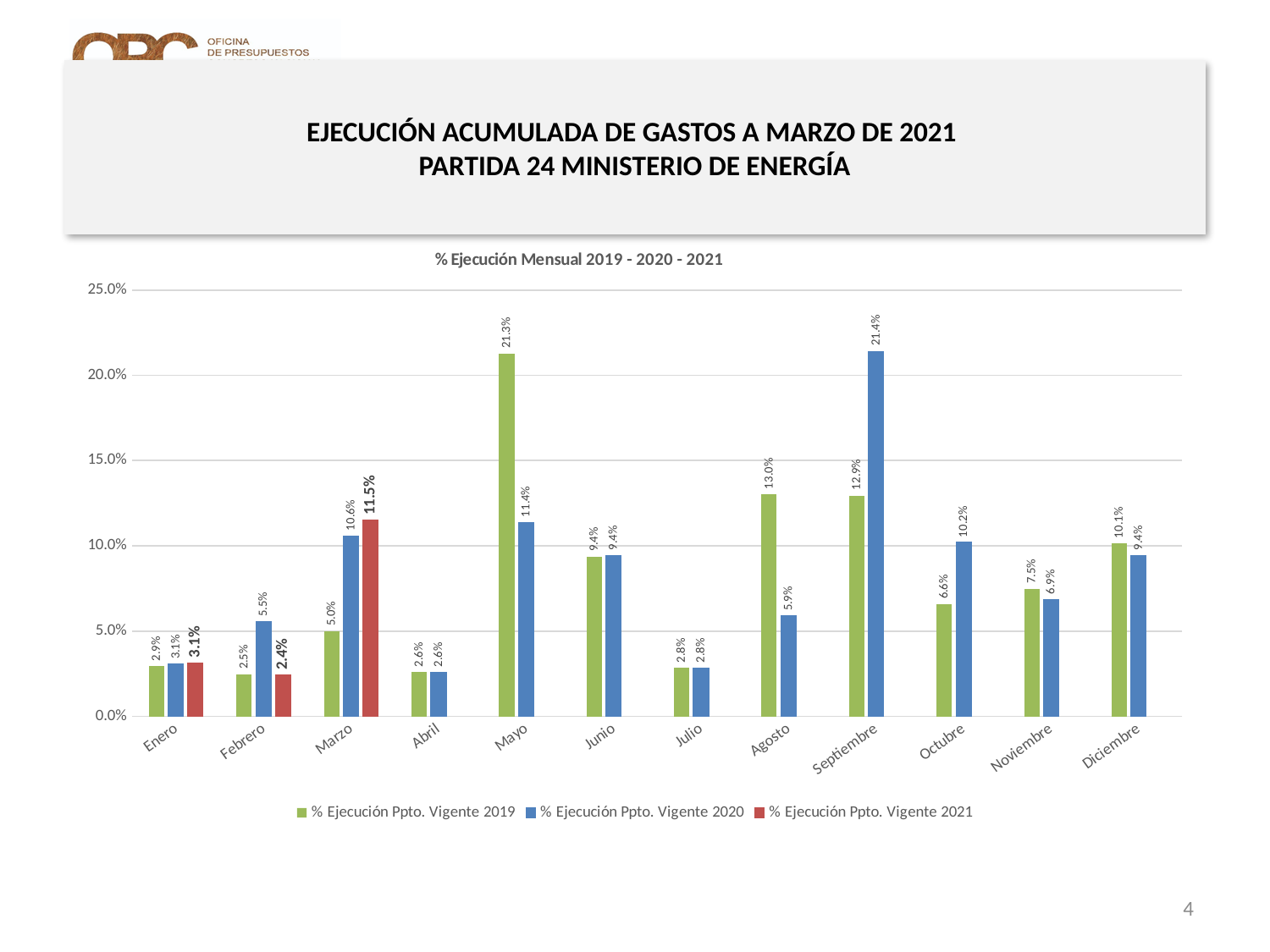
What is the value for % Ejecución Ppto. Vigente 2020 in Octubre? 10.2% What kind of chart is shown? Bar chart What is the title of the chart? % Ejecución Mensual 2019 - 2020 - 2021 In which month is the % Ejecución Ppto. Vigente 2019 series lowest? Febrero What is the difference between the 2020 and 2019 values in Marzo? 5.6% Which is larger in Agosto: the 2019 value or the 2020 value? 2019 What is the value for % Ejecución Ppto. Vigente 2021 in Marzo? 11.5% How many series does the legend list? 3 What is the value for % Ejecución Ppto. Vigente 2019 in Mayo? 21.3% In which month is the % Ejecución Ppto. Vigente 2020 series highest? Septiembre How many months are shown on the x axis? 12 Is the value for % Ejecución Ppto. Vigente 2020 in Septiembre greater or less than 20.0%? greater